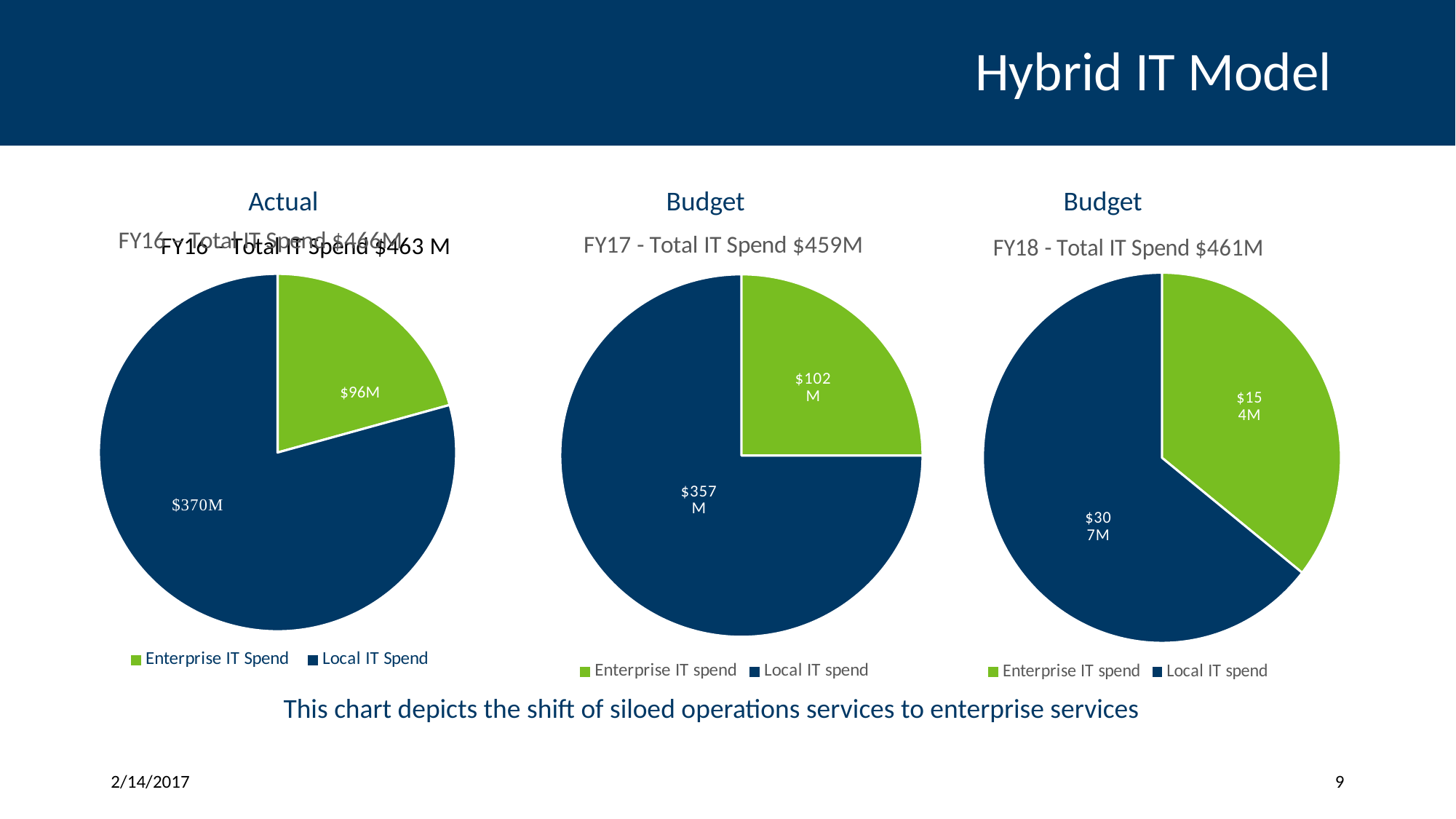
In the FY17 pie chart (middle), what is the value for Enterprise IT spend? $102M In the FY16 pie chart (left), what is the value for Local IT Spend? $370M What is the title of the middle pie chart? FY17 - Total IT Spend $459M In the FY18 pie chart (right), what is the value for Enterprise IT spend? $154M In the FY17 pie chart (middle), what is the value for Local IT spend? $357M In the FY18 pie chart (right), which slice is larger, Enterprise IT spend or Local IT spend? Local IT spend In the FY16 pie chart (left), what is the value for Enterprise IT Spend? $96M In the FY17 pie chart (middle), what is the difference between Local IT spend and Enterprise IT spend? $255M In the FY16 pie chart (left), what is the difference between Local IT Spend and Enterprise IT Spend? $274M How many slices does the FY18 pie chart (right) have? 2 What kind of chart is used for the FY17 chart (middle)? Pie chart In the FY18 pie chart (right), what is the value for Local IT spend? $307M